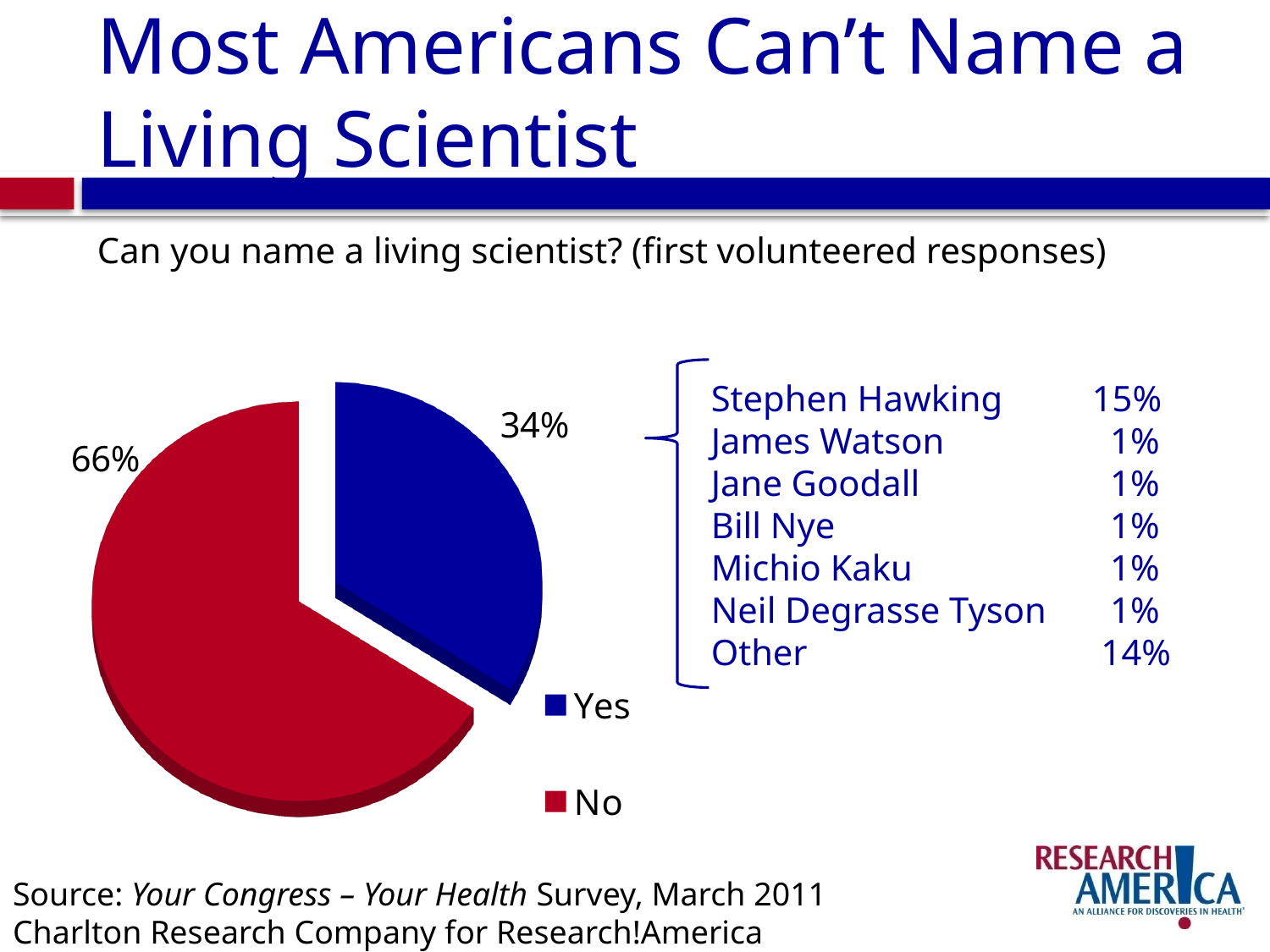
What percentage of respondents answered No in the pie chart? 66% Is the value for Yes greater or less than 50%? less Which slice of the pie chart is larger, Yes or No? No What percentage of respondents answered Yes in the pie chart? 34% Which slice of the pie chart is the smallest? Yes Which of the two slices, Yes or No, is shown in blue? Yes What is the question shown above the pie chart? Can you name a living scientist? (first volunteered responses) What colour is the No slice of the pie chart? red What is the difference in percentage points between the No and Yes slices? 32 What is the total of the Yes and No slices in the pie chart? 100% How many slices does the pie chart have? 2 What kind of chart is shown on the slide? pie chart